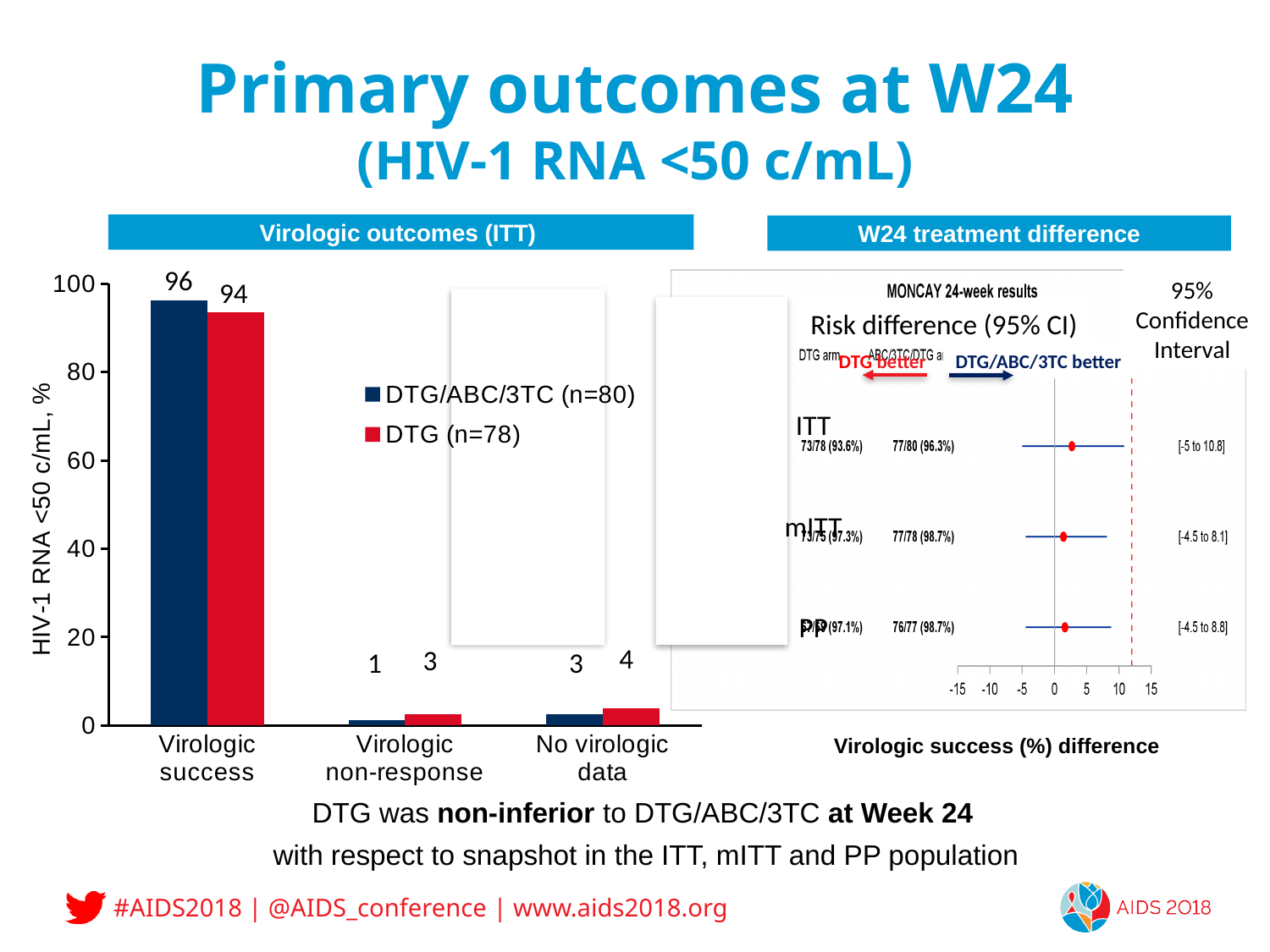
How many series does the legend of the Virologic outcomes (ITT) chart list? 2 What kind of chart is the Virologic outcomes (ITT) chart? Bar chart In the Virologic outcomes (ITT) bar chart, what is the value for DTG (n=78) in the Virologic success category? 94 In the Virologic outcomes (ITT) bar chart, what is the value for DTG/ABC/3TC (n=80) in the Virologic success category? 96 In the Virologic outcomes (ITT) bar chart, what is the difference between the DTG/ABC/3TC (n=80) and DTG (n=78) values for Virologic success? 2 In the Virologic outcomes (ITT) bar chart, which category has the lowest value for DTG/ABC/3TC (n=80)? Virologic non-response In the Virologic outcomes (ITT) bar chart, what is the value for DTG/ABC/3TC (n=80) in the No virologic data category? 3 In the Virologic outcomes (ITT) bar chart, which category has the highest value for DTG (n=78)? Virologic success In the Virologic outcomes (ITT) bar chart, what is the value for DTG (n=78) in the Virologic non-response category? 3 In the Virologic outcomes (ITT) bar chart, which series has the larger value for No virologic data, DTG/ABC/3TC (n=80) or DTG (n=78)? DTG (n=78) In the W24 treatment difference plot, what is the 95% confidence interval shown for the ITT population? [-5 to 10.8] How many categories are shown on the x axis of the Virologic outcomes (ITT) bar chart? 3